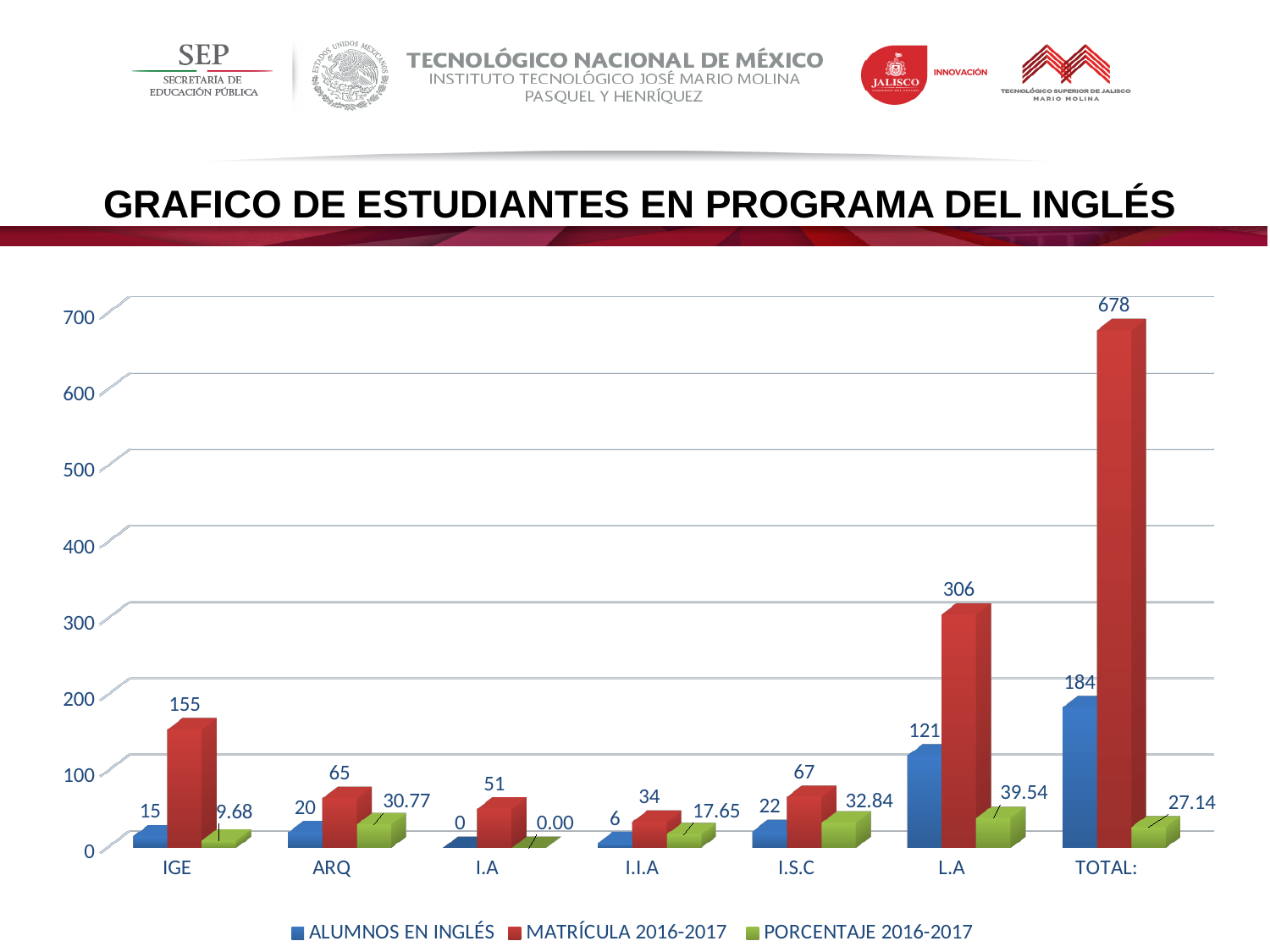
Which is larger, the ALUMNOS EN INGLÉS value for L.A or for TOTAL:? TOTAL: Excluding TOTAL:, which category has the highest PORCENTAJE 2016-2017 value? L.A What is the MATRÍCULA 2016-2017 value for L.A? 306 What is the PORCENTAJE 2016-2017 value for ARQ? 30.77 Excluding TOTAL:, which category has the lowest MATRÍCULA 2016-2017 value? I.I.A What is the ALUMNOS EN INGLÉS value for I.S.C? 22 What kind of chart is shown on the slide? bar chart Is the MATRÍCULA 2016-2017 value for TOTAL: greater or less than 600? greater What is the ALUMNOS EN INGLÉS value for I.A? 0 What is the difference between the MATRÍCULA 2016-2017 values for IGE and ARQ? 90 How many series does the legend list? 3 How many categories are shown on the x axis? 7